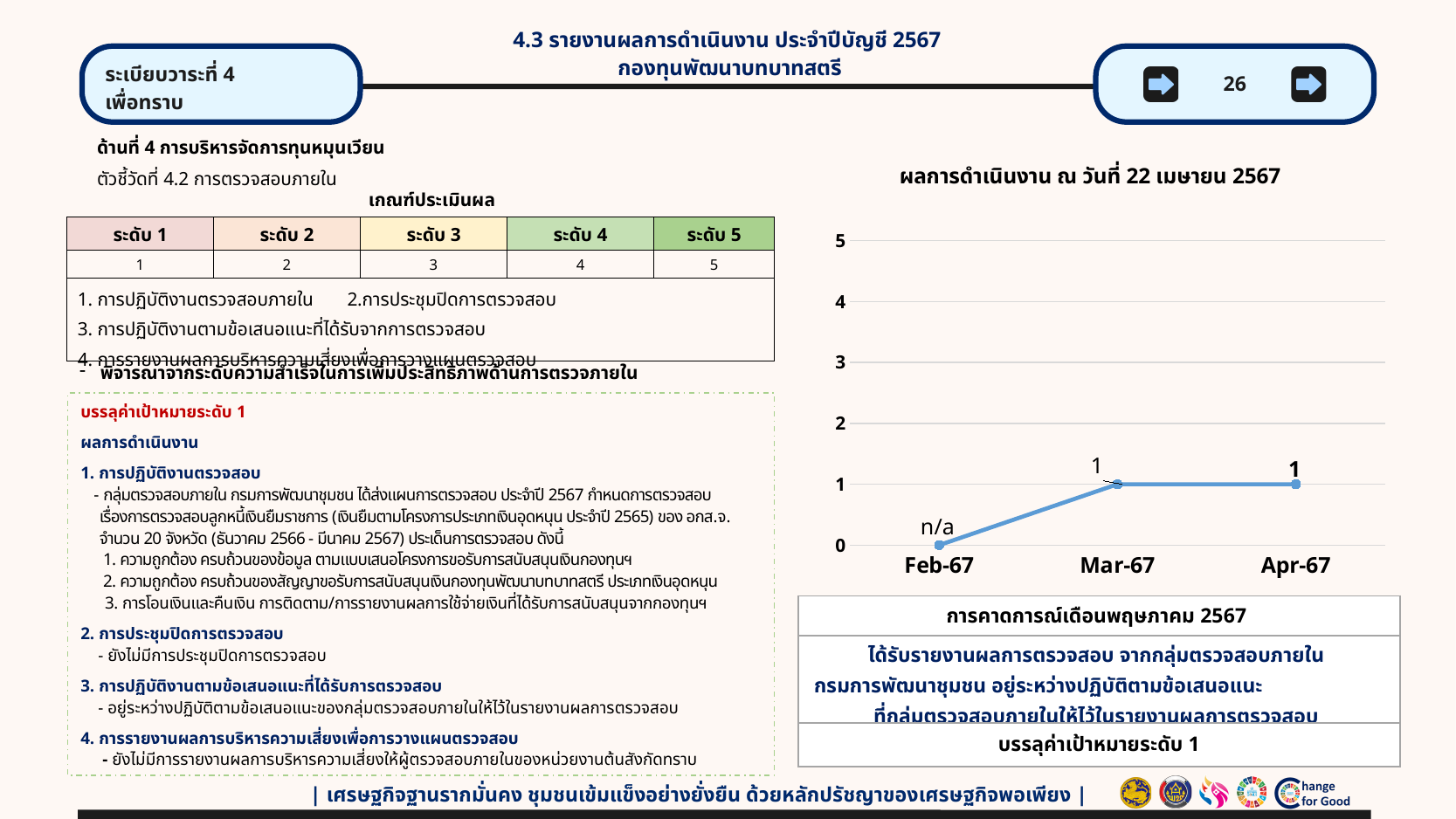
Is the value for Apr-67 greater or less than 3? less What data label is shown for Feb-67 in the line chart? n/a What kind of chart is shown on the slide? line chart What is the difference between the values for Mar-67 and Apr-67? 0 How many months are plotted on the x axis of the line chart? 3 Does the line rise, fall or stay flat between Mar-67 and Apr-67? stays flat What is the highest value shown on the y axis of the line chart? 5 What is the title of the line chart? ผลการดำเนินงาน ณ วันที่ 22 เมษายน 2567 Does the line rise or fall from Feb-67 to Mar-67? rises Is the value for Mar-67 greater or less than 2? less What is the value for Apr-67 in the line chart? 1 What is the value for Mar-67 in the line chart? 1